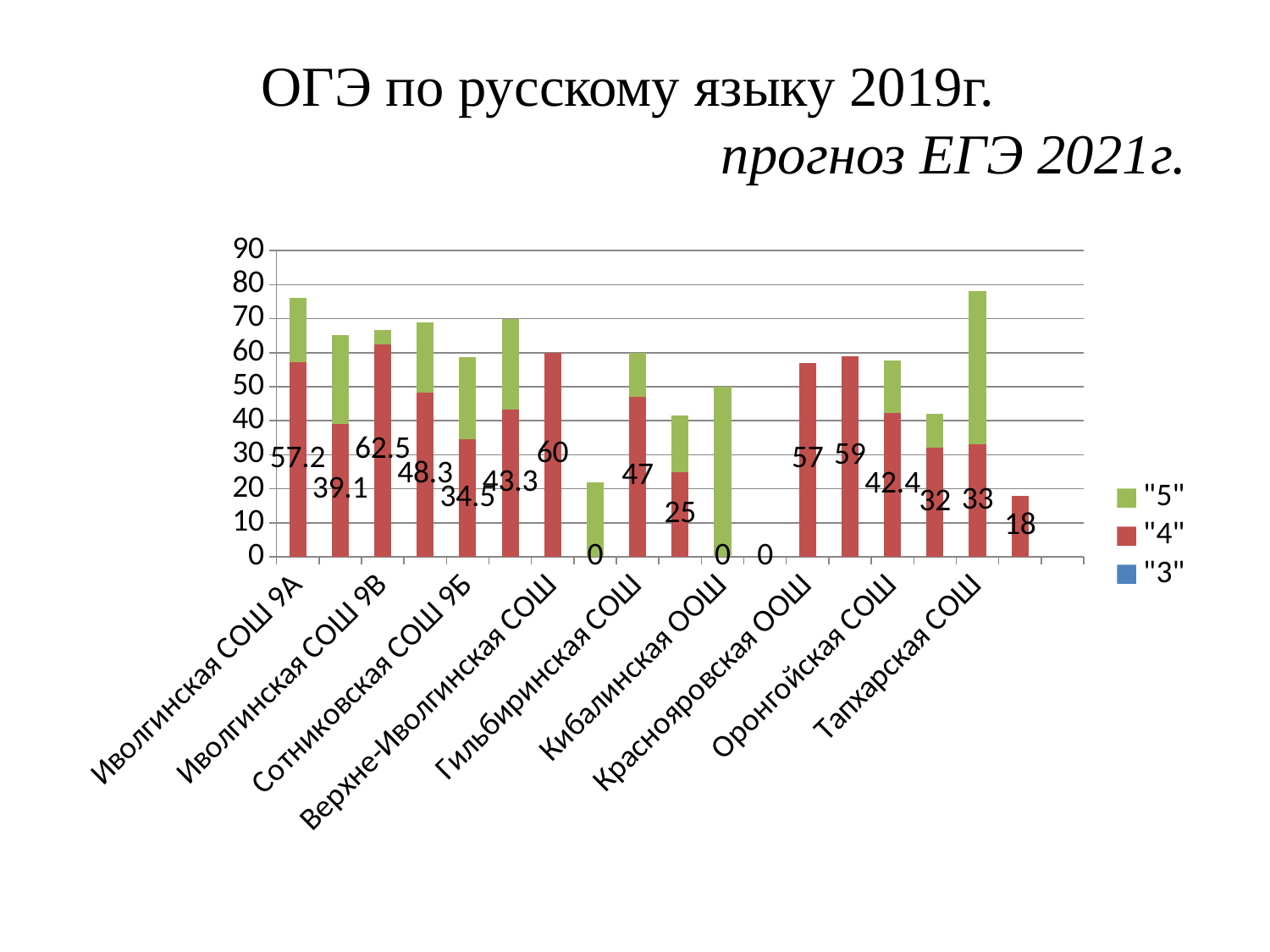
What is the value of the "4" series for Краснояровская ООШ? 57 What is the value of the "4" series for Верхне-Иволгинская СОШ? 60 What is the value of the "4" series for Тапхарская СОШ? 33 What is the value of the "4" series for Иволгинская СОШ 9А? 57.2 How many series does the legend list? 3 Is the total height of the bar for Кибалинская ООШ greater or less than 40? greater What are the entries in the chart legend? "5", "4", "3" What kind of chart is shown on the slide? bar chart What is the highest data label printed for the "4" series? 62.5 Which has the larger "4" value: Гильбиринская СОШ or Оронгойская СОШ? Гильбиринская СОШ What is the difference between the "4" values for Иволгинская СОШ 9В (62.5) and Иволгинская СОШ 9А (57.2)? 5.3 How many bars are plotted in the chart? 17